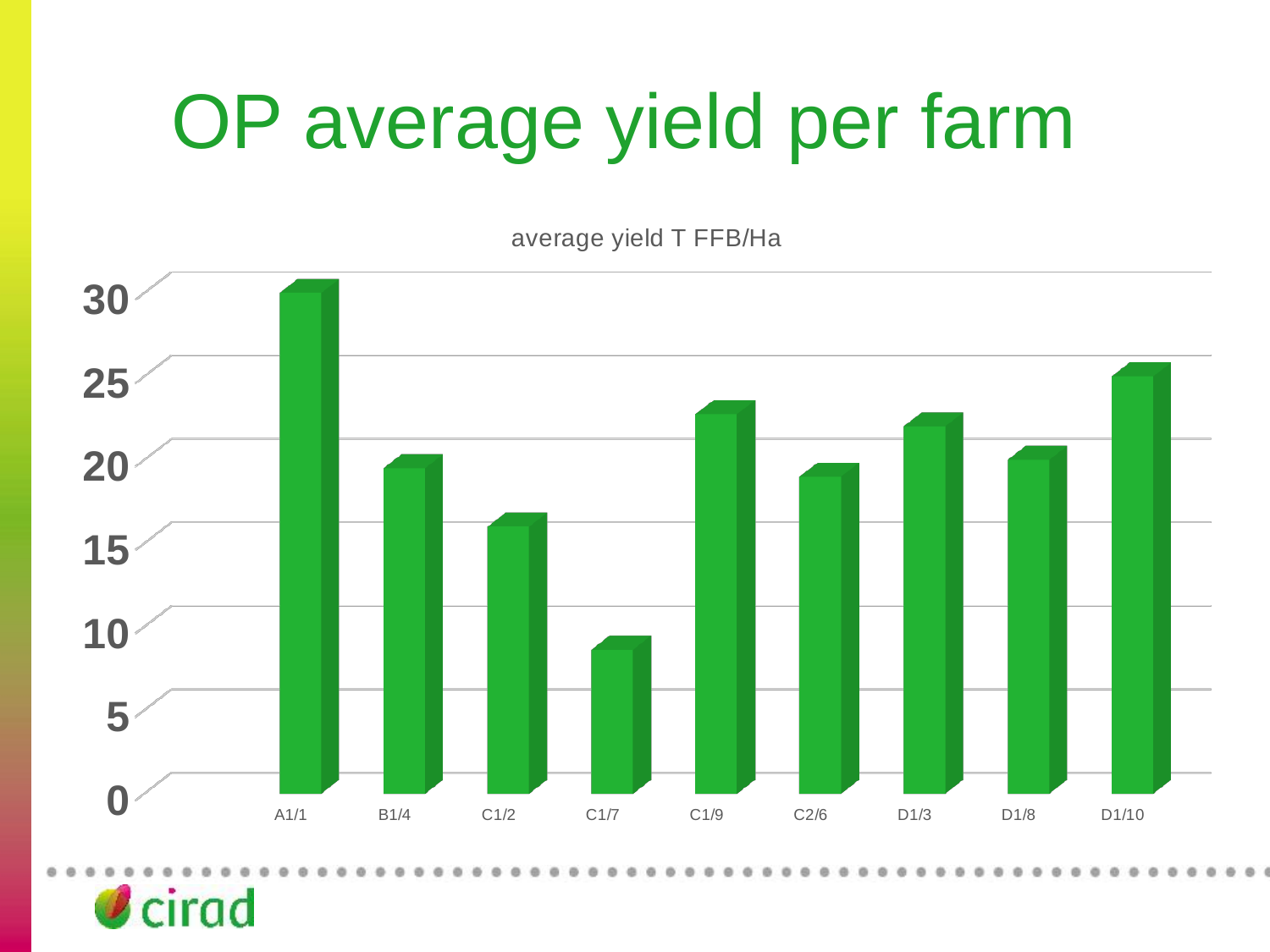
What is the title printed above the chart? average yield T FFB/Ha Is the average yield for A1/1 greater or less than 25? greater How many farms (categories) are plotted on the x axis? 9 Is the average yield for B1/4 greater or less than 15? greater Is the average yield for C1/7 greater or less than 10? less Which farm has a higher average yield, A1/1 or D1/10? A1/1 Which farm has the highest average yield? A1/1 What kind of chart is shown on the slide? bar chart Which farm has a higher average yield, C1/2 or C1/7? C1/2 Which farm has the lowest average yield? C1/7